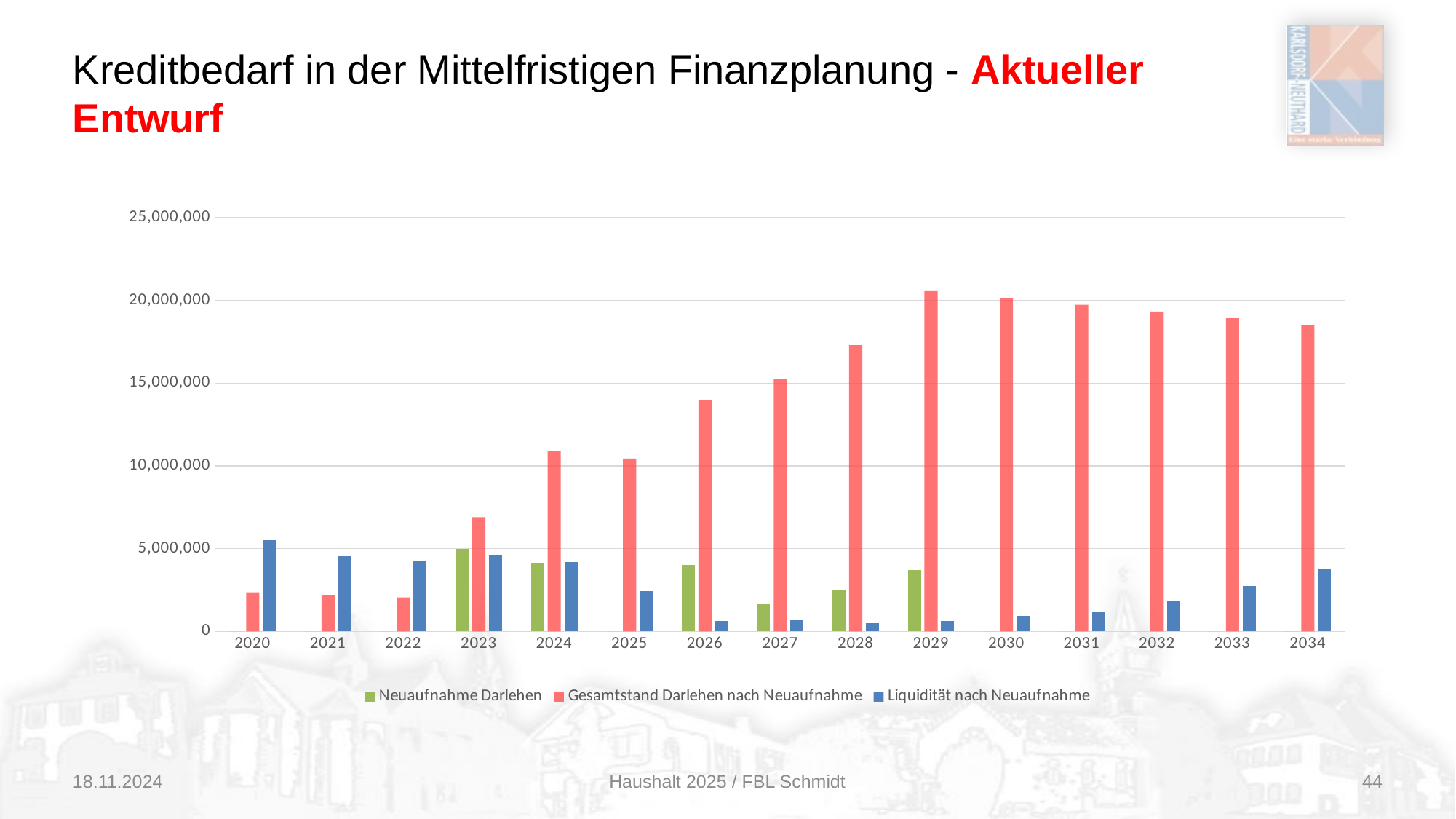
Which colour represents Gesamtstand Darlehen nach Neuaufnahme in the legend? red In which year is the value for Neuaufnahme Darlehen highest? 2023 In which year is the value for Gesamtstand Darlehen nach Neuaufnahme highest? 2029 In which year is the value for Liquidität nach Neuaufnahme highest? 2020 How many series does the legend list? 3 Is the value for Gesamtstand Darlehen nach Neuaufnahme in 2029 greater or less than 20,000,000? greater Is the value for Gesamtstand Darlehen nach Neuaufnahme in 2026 greater or less than 15,000,000? less Does the value for Gesamtstand Darlehen nach Neuaufnahme rise or fall from 2029 to 2034? fall Is the value for Liquidität nach Neuaufnahme in 2020 greater or less than 5,000,000? greater What kind of chart is shown on the slide? bar chart How many years are shown on the x axis? 15 Which is larger: Liquidität nach Neuaufnahme in 2020 or in 2034? 2020